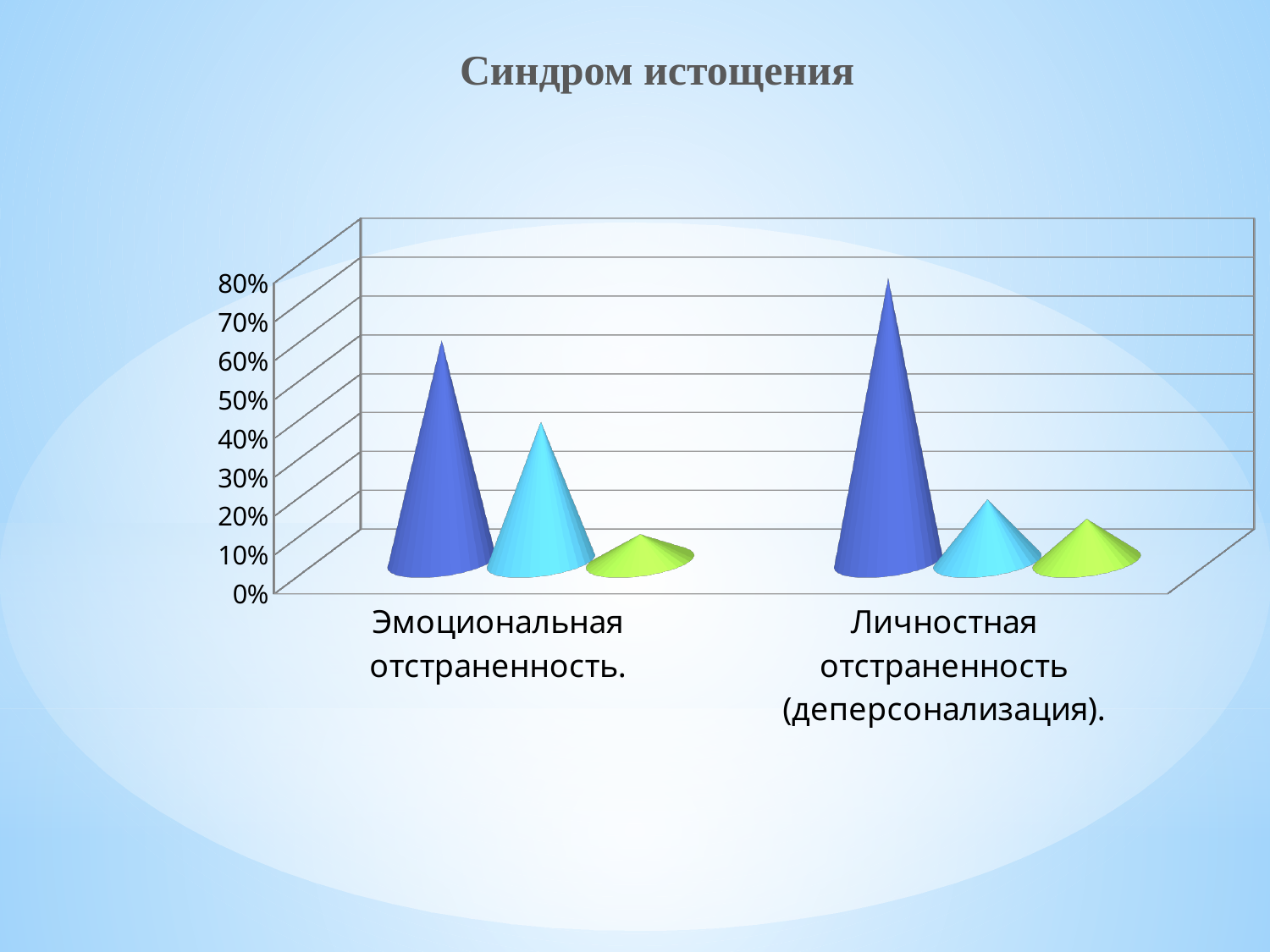
Is the value of the dark blue bar for Личностная отстраненность (деперсонализация) greater or less than 60%? greater Which bar is the tallest in the Эмоциональная отстраненность category? the dark blue bar Which category has the taller dark blue bar, Эмоциональная отстраненность or Личностная отстраненность (деперсонализация)? Личностная отстраненность (деперсонализация) What is the title of the chart? Синдром истощения Is the value of the green bar for Эмоциональная отстраненность greater or less than 20%? less Is the value of the dark blue bar for Эмоциональная отстраненность greater or less than 50%? greater Which category has the taller light blue bar, Эмоциональная отстраненность or Личностная отстраненность (деперсонализация)? Эмоциональная отстраненность What kind of chart is shown on the slide? bar chart How many bars are plotted for each category in the chart? 3 How many categories are shown on the x axis of the chart? 2